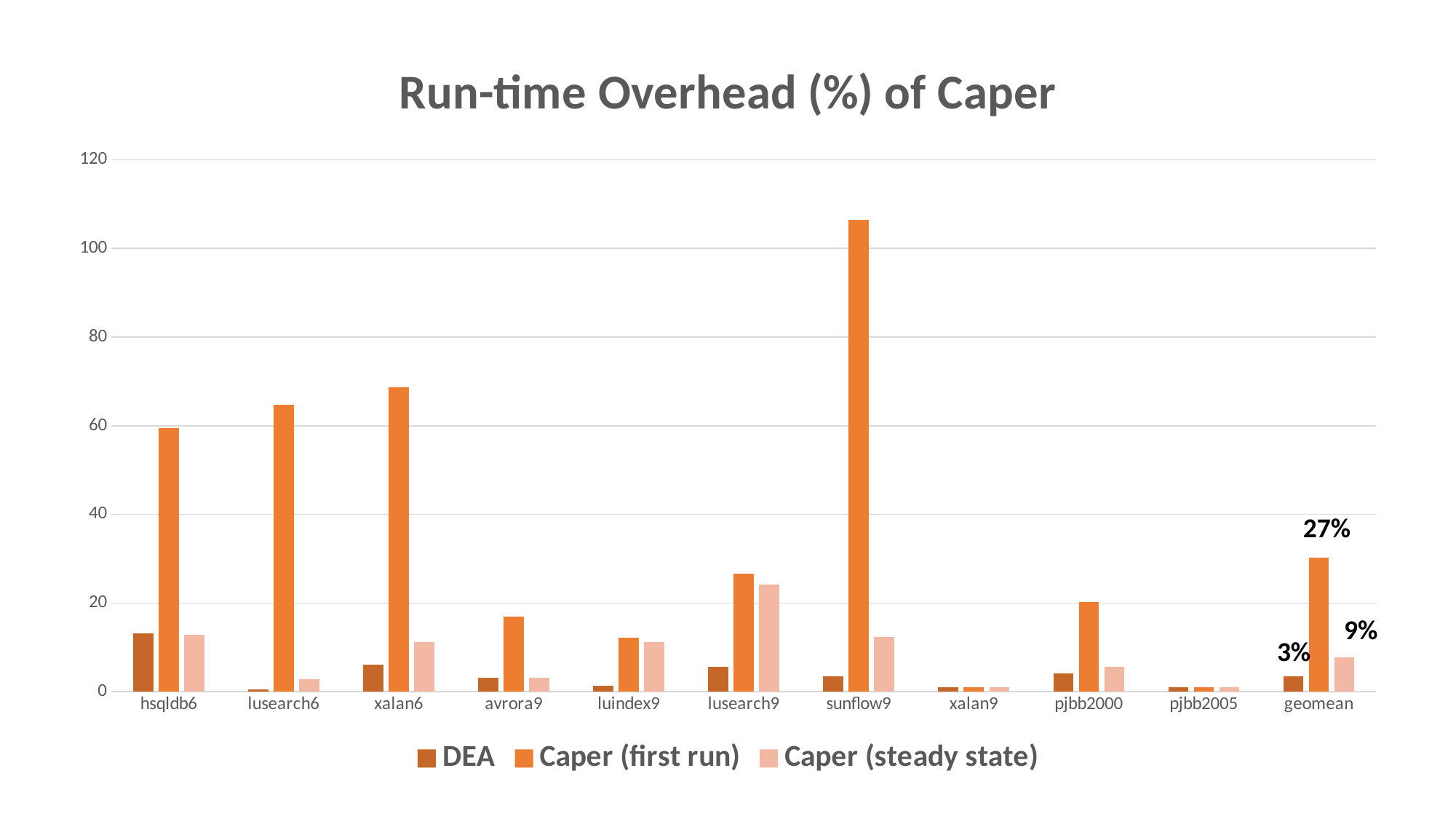
What is the title of the chart? Run-time Overhead (%) of Caper How many categories are shown along the x axis of the chart? 11 What kind of chart is shown on the slide? bar chart Which category has the highest Caper (first run) value? sunflow9 Is the Caper (first run) value for xalan6 greater or less than 60? greater How many series does the legend list? 3 What is the labelled value for Caper (steady state) at geomean? 9% Is the Caper (first run) value for sunflow9 greater or less than 100? greater What is the labelled value for Caper (first run) at geomean? 27% Which is larger: the Caper (first run) value for hsqldb6 or for lusearch6? lusearch6 What is the labelled value for DEA at geomean? 3% For pjbb2000, which is larger: Caper (first run) or Caper (steady state)? Caper (first run)